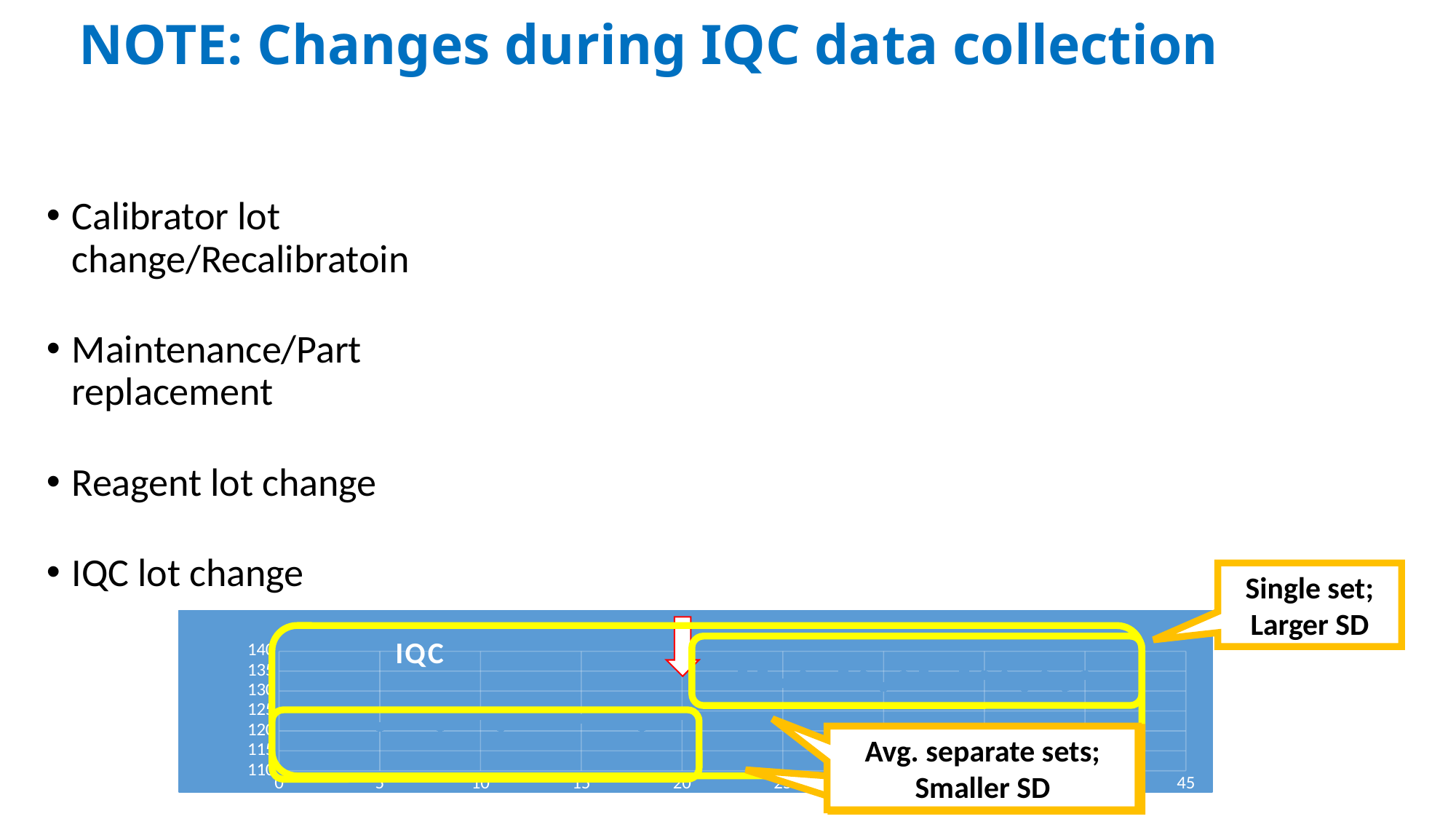
In the IQC chart, are the plotted values after x = 20 greater or less than 125? greater What is the highest tick label shown on the y axis of the IQC chart? 140 What is the largest tick label shown on the x axis of the IQC chart? 45 What is the title of the chart at the bottom of the slide? IQC What kind of chart is the IQC chart? line chart In the IQC chart, do the plotted values rise or fall after the point marked by the red arrow near x = 20? rise In the IQC chart, which group of points is higher: those before x = 20 or those after x = 20? those after x = 20